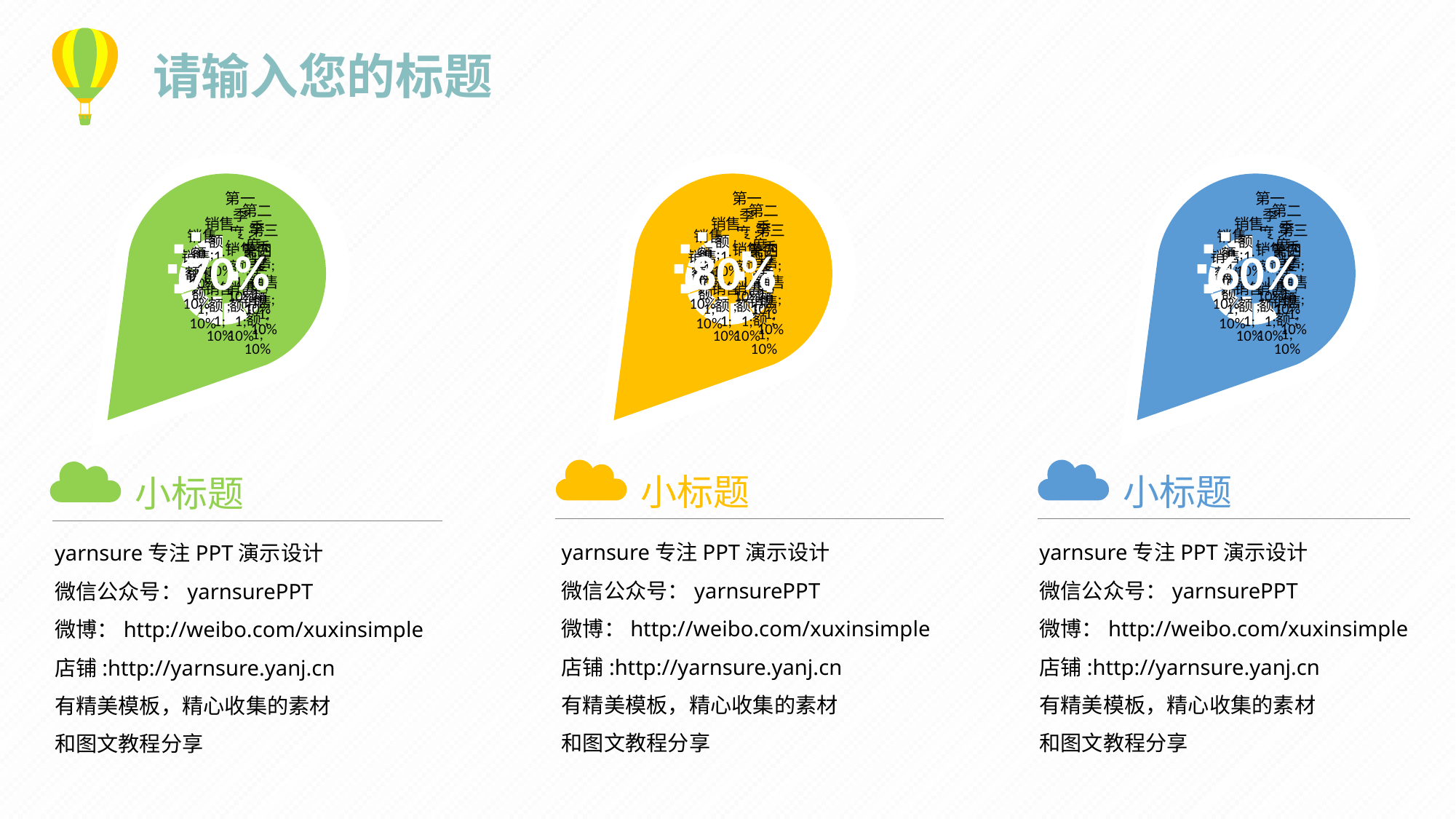
What percentage is displayed in the blue chart on the right? 60% Which of the three charts displays the highest percentage? The yellow chart in the middle (80%) What colour is the chart on the left? green What is the difference between the percentage shown in the yellow chart and the percentage shown in the blue chart? 20% How many charts are shown on the slide? 3 Which of the three charts displays the lowest percentage? The blue chart on the right (60%) What percentage is displayed in the green chart on the left? 70% What percentage is displayed in the yellow chart in the middle? 80% Is the percentage shown in the green chart larger or smaller than the percentage shown in the yellow chart? smaller